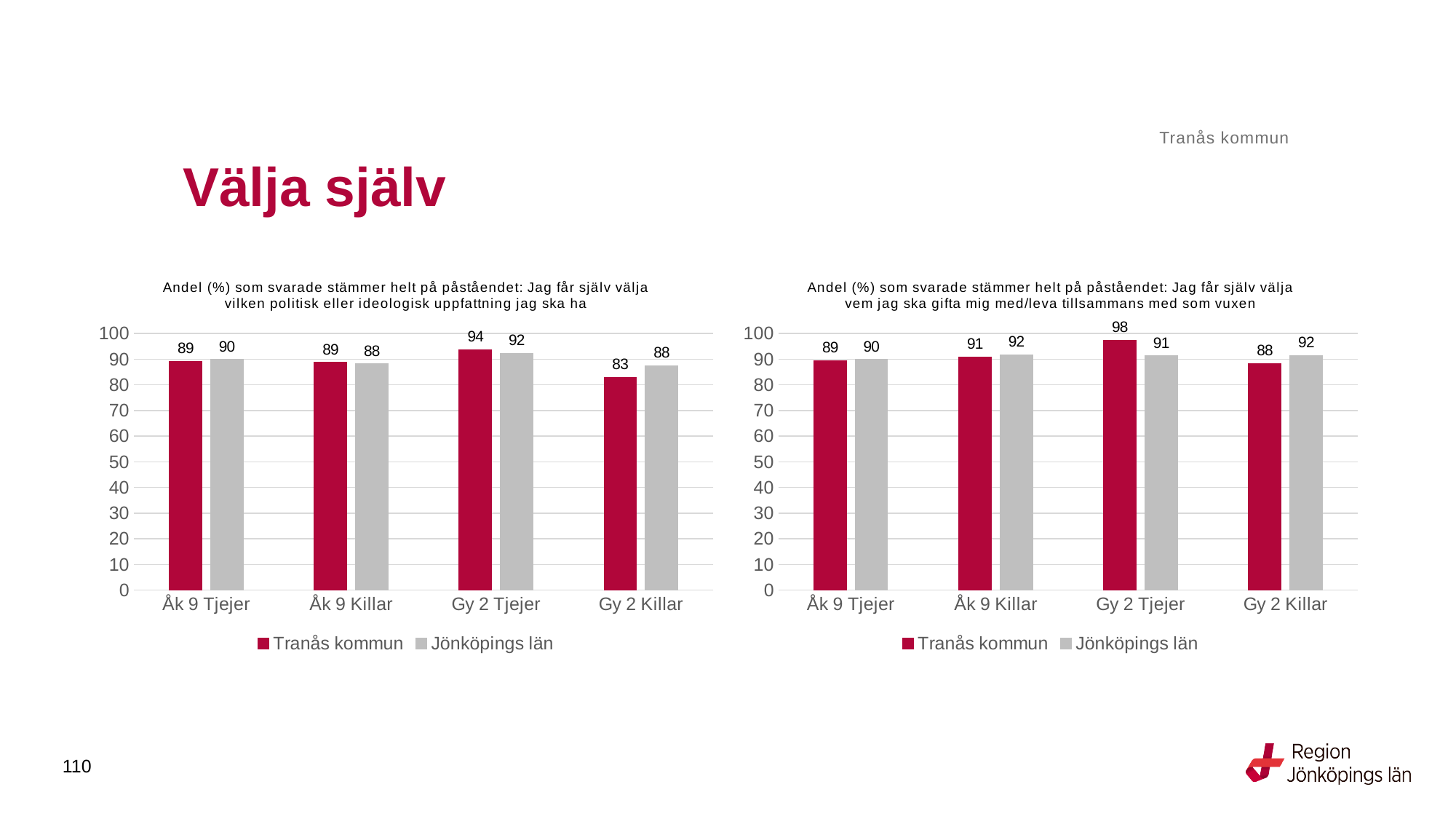
In the right chart, what is the difference between Tranås kommun and Jönköpings län for Gy 2 Tjejer? 7 In the right chart, what is the value for Jönköpings län for Åk 9 Killar? 92 How many series does the legend of the right chart list? 2 How many categories are shown on the x axis of the left chart? 4 In the right chart, what is the value for Tranås kommun for Gy 2 Tjejer? 98 In the left chart, what is the difference between Jönköpings län and Tranås kommun for Gy 2 Killar? 5 In the left chart, which category has the lowest value for Tranås kommun? Gy 2 Killar In the right chart, which category has the lowest value for Tranås kommun? Gy 2 Killar In the left chart, what is the value for Tranås kommun for Gy 2 Killar? 83 In the right chart, which is larger for Gy 2 Killar: Tranås kommun or Jönköpings län? Jönköpings län In the left chart, which category has the highest value for Tranås kommun? Gy 2 Tjejer In the left chart, what is the value for Jönköpings län for Gy 2 Tjejer? 92